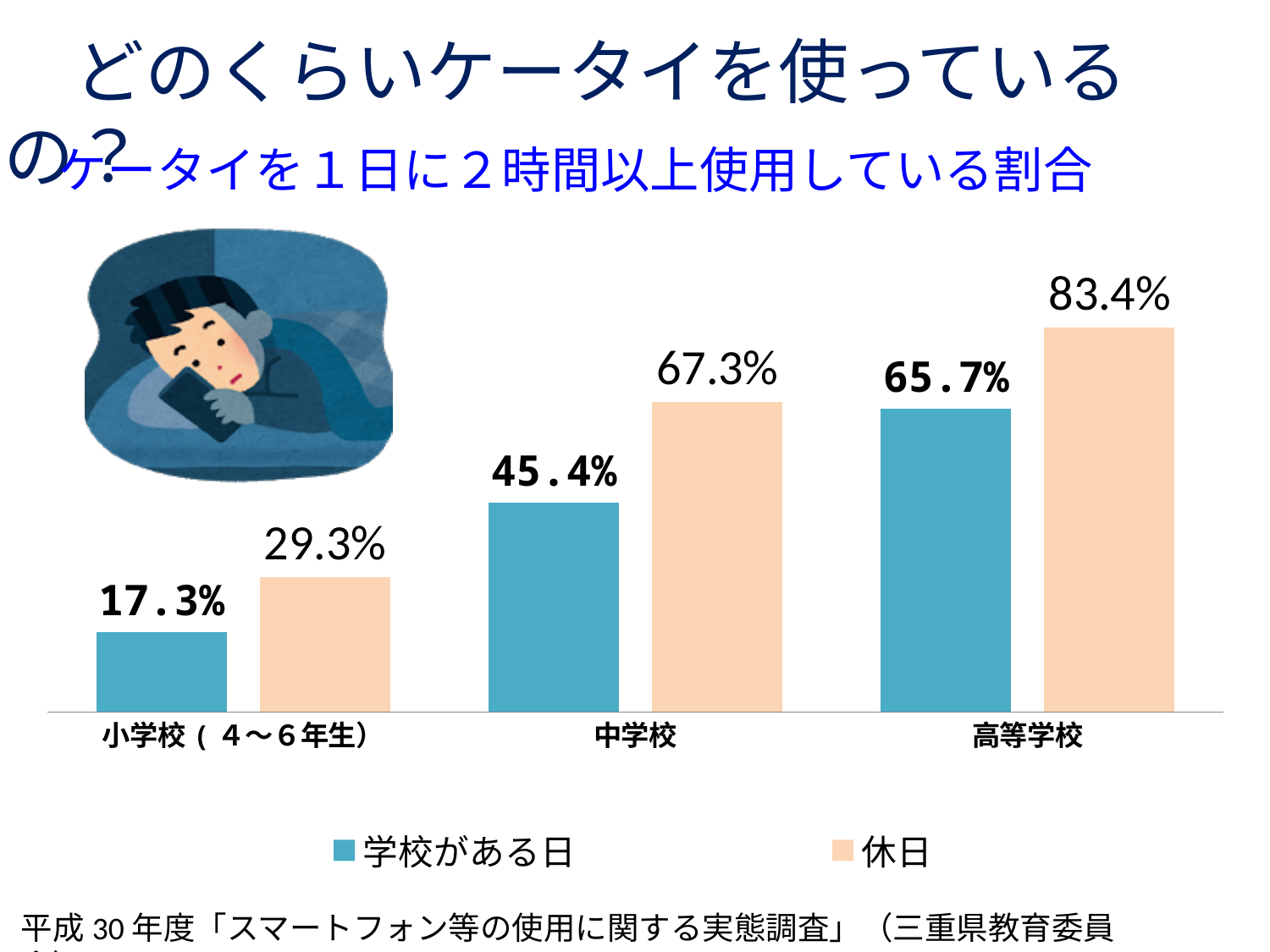
What kind of chart is shown on the slide? bar chart What is the value for 小学校（４～６年生） on 学校がある日? 17.3% What is the value for 高等学校 on 学校がある日? 65.7% Which is larger: the 学校がある日 value for 中学校 or the 休日 value for 小学校（４～６年生）? 学校がある日 value for 中学校 How many series does the legend list? 2 What is the difference between the 休日 values for 中学校 and 小学校（４～６年生）? 38.0% What is the value for 中学校 on 休日? 67.3% How many categories are shown on the x axis? 3 Which category has the highest value for 休日? 高等学校 What is the difference between the 休日 and 学校がある日 values for 高等学校? 17.7% Which category has the lowest value for 学校がある日? 小学校（４～６年生） Do the 学校がある日 values rise or fall from 小学校 to 高等学校? rise